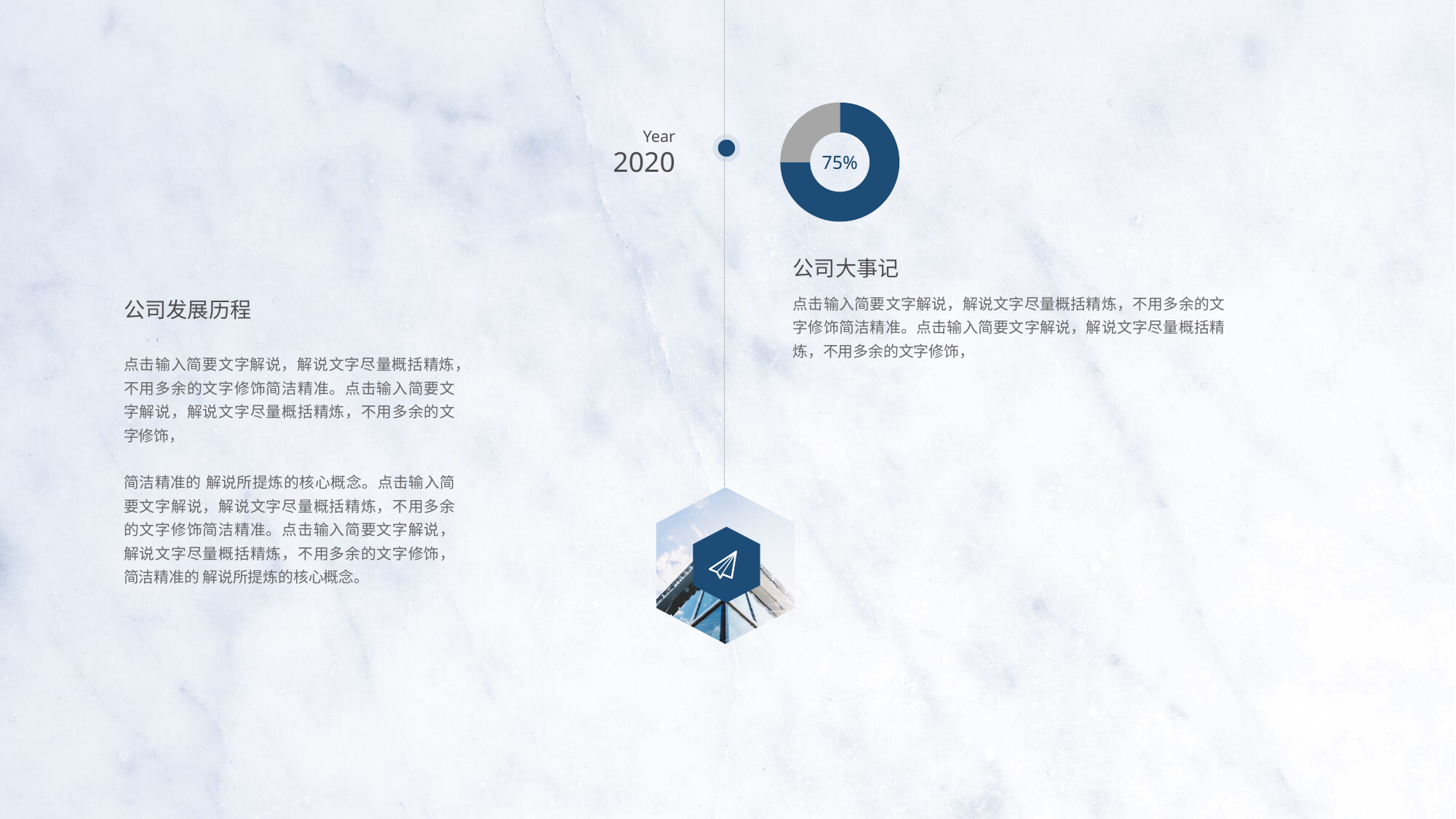
Which segment of the donut chart is larger, the blue one or the grey one? The blue one What percentage is printed in the centre of the donut chart? 75% What share of the donut chart does the blue segment represent? 75% How many segments does the donut chart have? 2 Is the blue segment of the donut chart greater or less than 50%? greater What kind of chart is shown on the slide? Donut chart What colour is the larger segment of the donut chart? Blue Is the grey segment of the donut chart greater or less than 50%? less Which year is labelled next to the donut chart on the timeline? 2020